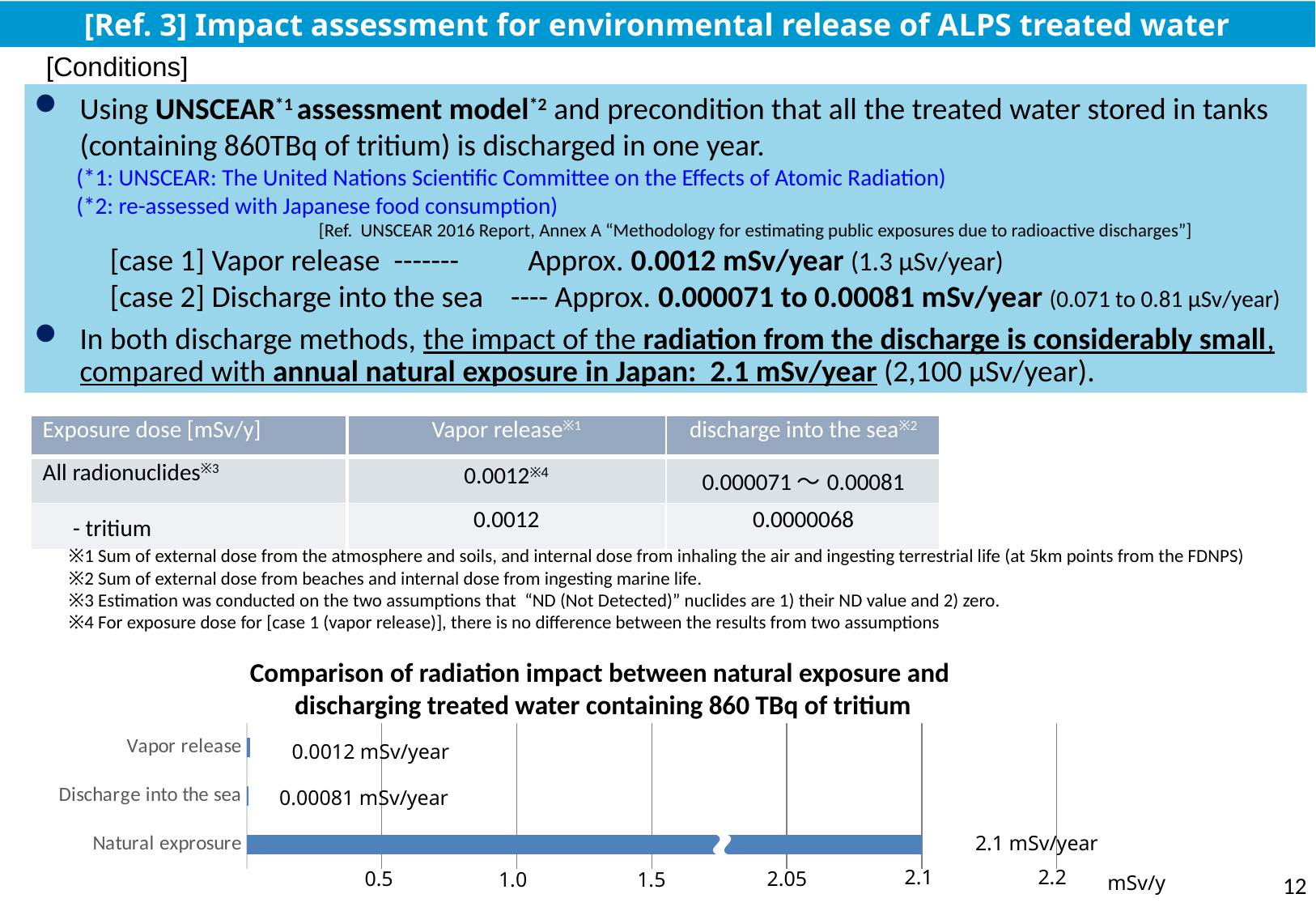
Which is larger in the chart, Vapor release or Discharge into the sea? Vapor release How many categories are plotted in the chart? 3 Is the value for Natural exposure greater or less than 1.0? greater What kind of chart is shown on the slide? bar chart What is the difference between the Natural exposure value and the Vapor release value in the chart? 2.0988 mSv/year What is the difference between the Vapor release value and the Discharge into the sea value in the chart? 0.00039 mSv/year What is the value shown for Discharge into the sea in the chart? 0.00081 mSv/year Which category has the highest value in the chart? Natural exprosure What unit is shown at the end of the chart's horizontal axis? mSv/y What is the value shown for Vapor release in the chart? 0.0012 mSv/year What is the value shown for Natural exposure in the chart? 2.1 mSv/year Which category has the lowest value in the chart? Discharge into the sea